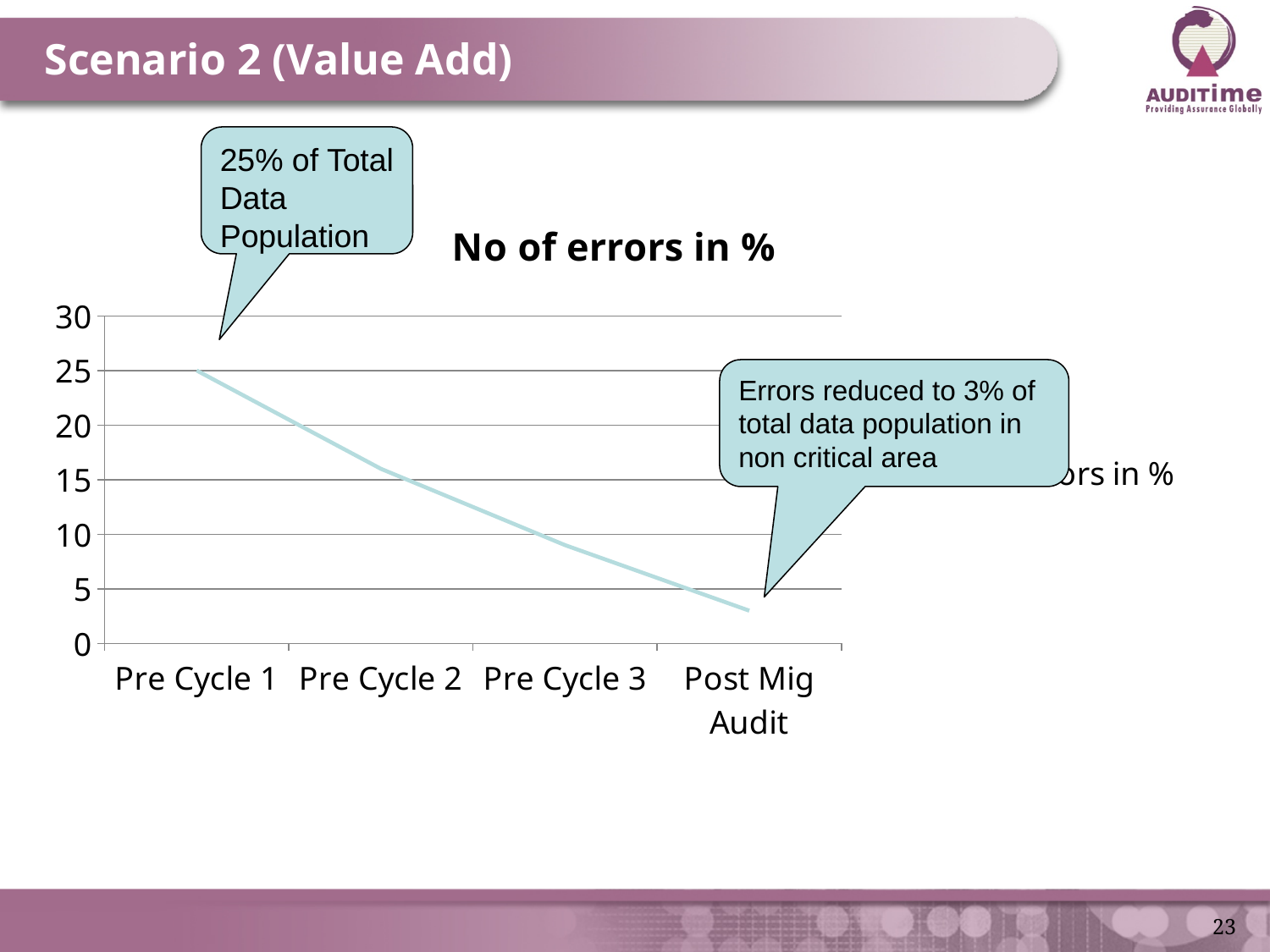
Which category has the lowest value? Post Mig Audit According to the callout, what percentage of the total data population are errors at Post Mig Audit? 3% Which is larger, the value for Pre Cycle 2 or the value for Pre Cycle 3? Pre Cycle 2 What is the value for Pre Cycle 1? 25 Is the value for Pre Cycle 2 greater or less than 20? less Which category has the highest value? Pre Cycle 1 What kind of chart is shown on the slide? line chart Is the value for Pre Cycle 3 greater or less than 15? less What is the title of the chart? No of errors in % How many categories are plotted along the x axis? 4 Do the values rise or fall from Pre Cycle 1 to Post Mig Audit? fall